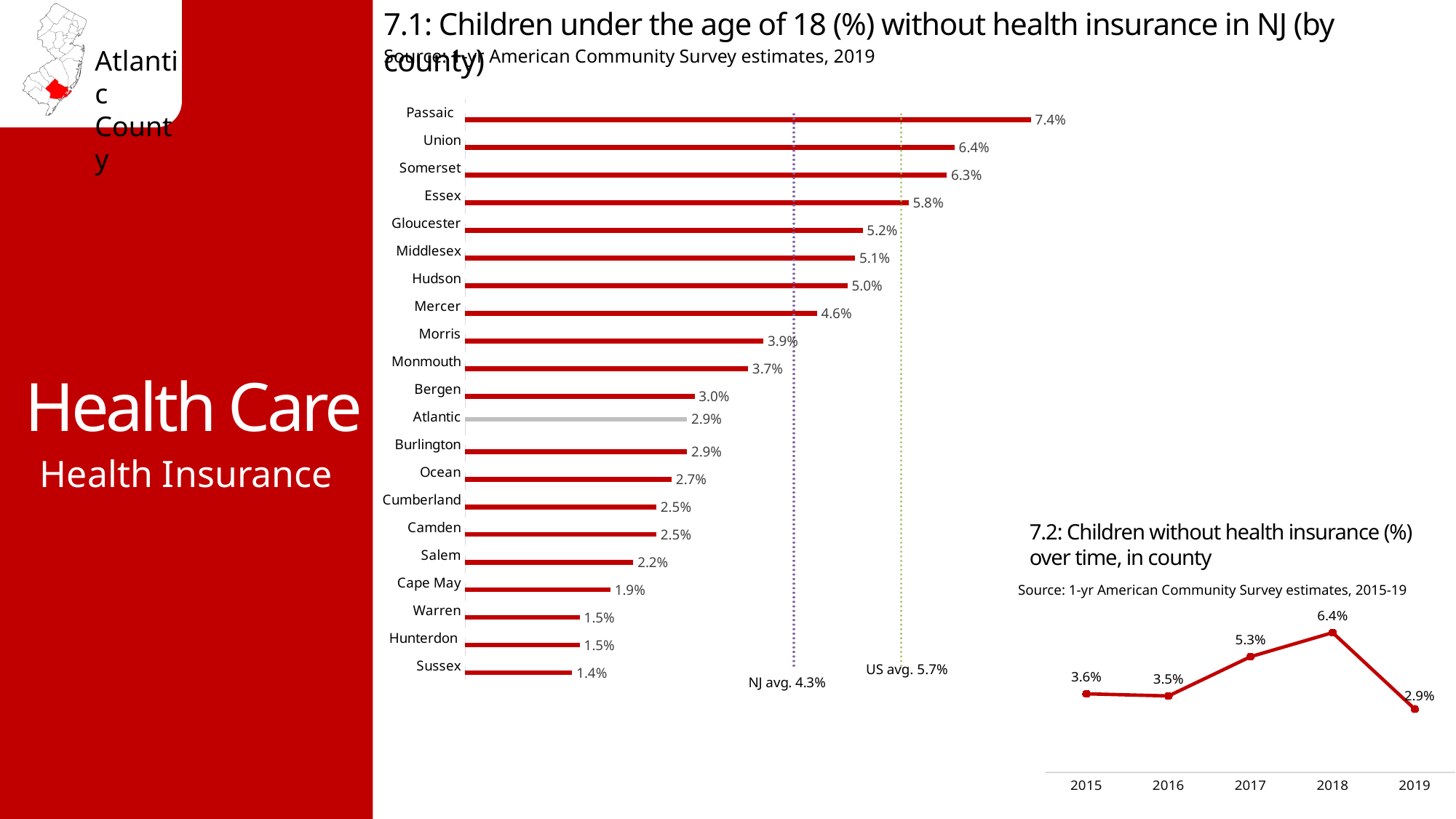
In chart 7.1, what is the value for Atlantic? 2.9% In chart 7.1 (children under 18 without health insurance by county), what is the value for Passaic? 7.4% In chart 7.1, how many counties are shown? 21 In chart 7.2 (children without health insurance over time), what is the value for 2018? 6.4% In chart 7.1, what is the difference between the values for Passaic and Sussex? 6.0% In chart 7.2, how many years are plotted? 5 In chart 7.1, which county has a higher value, Gloucester or Mercer? Gloucester In chart 7.1, what is the NJ average shown by the dotted reference line? 4.3% In chart 7.1, which county has the highest percentage of children without health insurance? Passaic In chart 7.1, which county has the lowest percentage of children without health insurance? Sussex What kind of chart is chart 7.1? Bar chart In chart 7.2, what is the difference between the values for 2018 and 2019? 3.5%